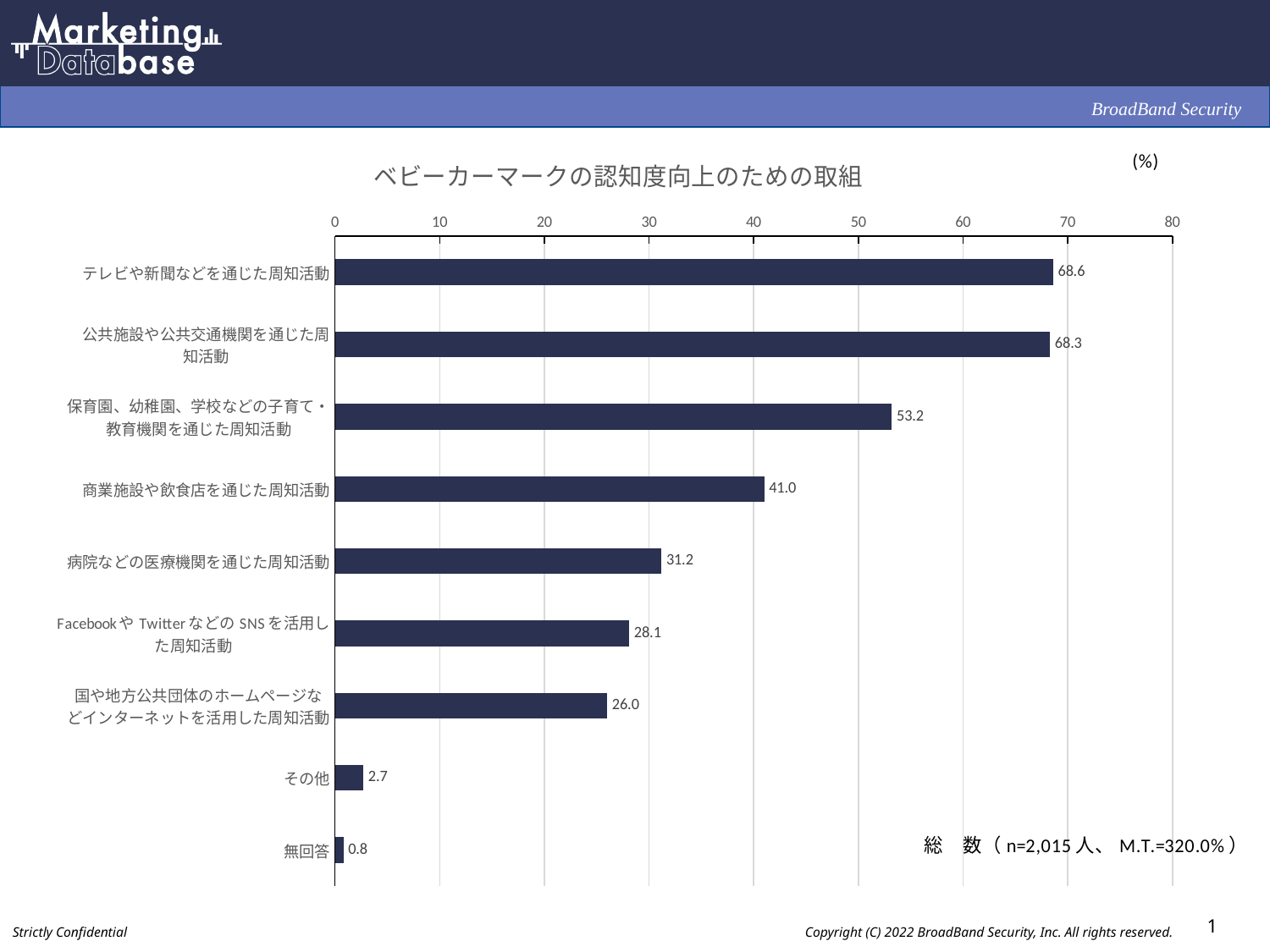
What is the value for 商業施設や飲食店を通じた周知活動? 41.0 What is the value for 病院などの医療機関を通じた周知活動? 31.2 What is the title of the chart? ベビーカーマークの認知度向上のための取組 What is the value for その他? 2.7 Which is larger: the value for Facebookや Twitter などの SNS を活用した周知活動 or the value for 国や地方公共団体のホームページなどインターネットを活用した周知活動? Facebookや Twitter などの SNS を活用した周知活動 How many categories are shown in the chart? 9 Is the value for 公共施設や公共交通機関を通じた周知活動 greater or less than 60? greater What type of chart is shown on the slide? bar chart Which category has the lowest value? 無回答 Which category has the highest value? テレビや新聞などを通じた周知活動 What is the value for テレビや新聞などを通じた周知活動? 68.6 What is the difference between the values for 保育園、幼稚園、学校などの子育て・教育機関を通じた周知活動 and 商業施設や飲食店を通じた周知活動? 12.2